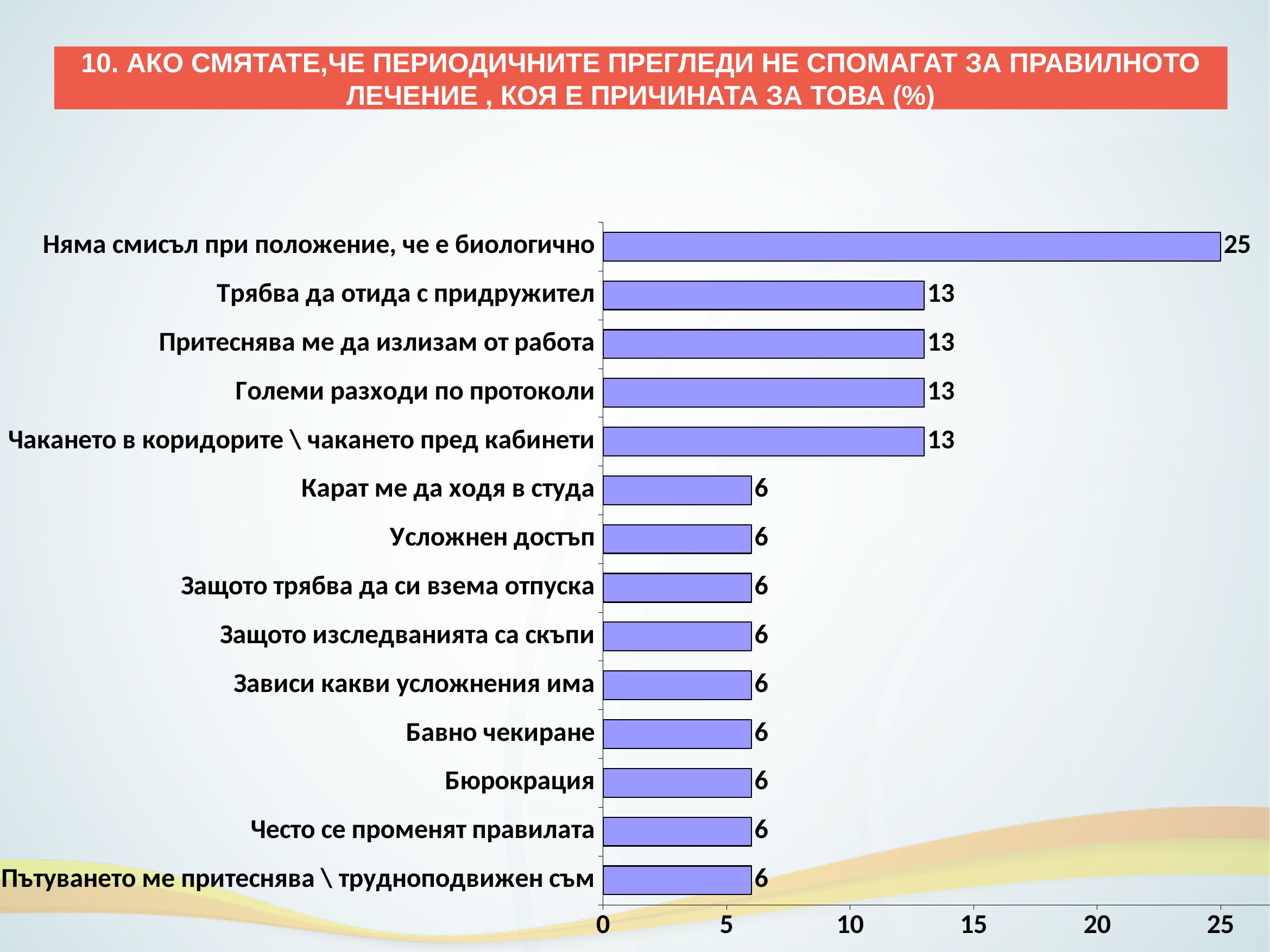
What is the value for "Чакането в коридорите \ чакането пред кабинети"? 13 What is the value for "Няма смисъл при положение, че е биологично"? 25 Which category has the highest value? Няма смисъл при положение, че е биологично What is the value for "Трябва да отида с придружител"? 13 What kind of chart is shown on the slide? bar chart What is the difference between the values for "Притеснява ме да излизам от работа" and "Усложнен достъп"? 7 Which is larger, the value for "Големи разходи по протоколи" or the value for "Бавно чекиране"? Големи разходи по протоколи What is the value for "Бюрокрация"? 6 How many categories are shown in the chart? 14 How many categories have a value of 6? 9 What is the difference between the values for "Няма смисъл при положение, че е биологично" and "Големи разходи по протоколи"? 12 Is the value for "Карат ме да ходя в студа" greater or less than 10? less